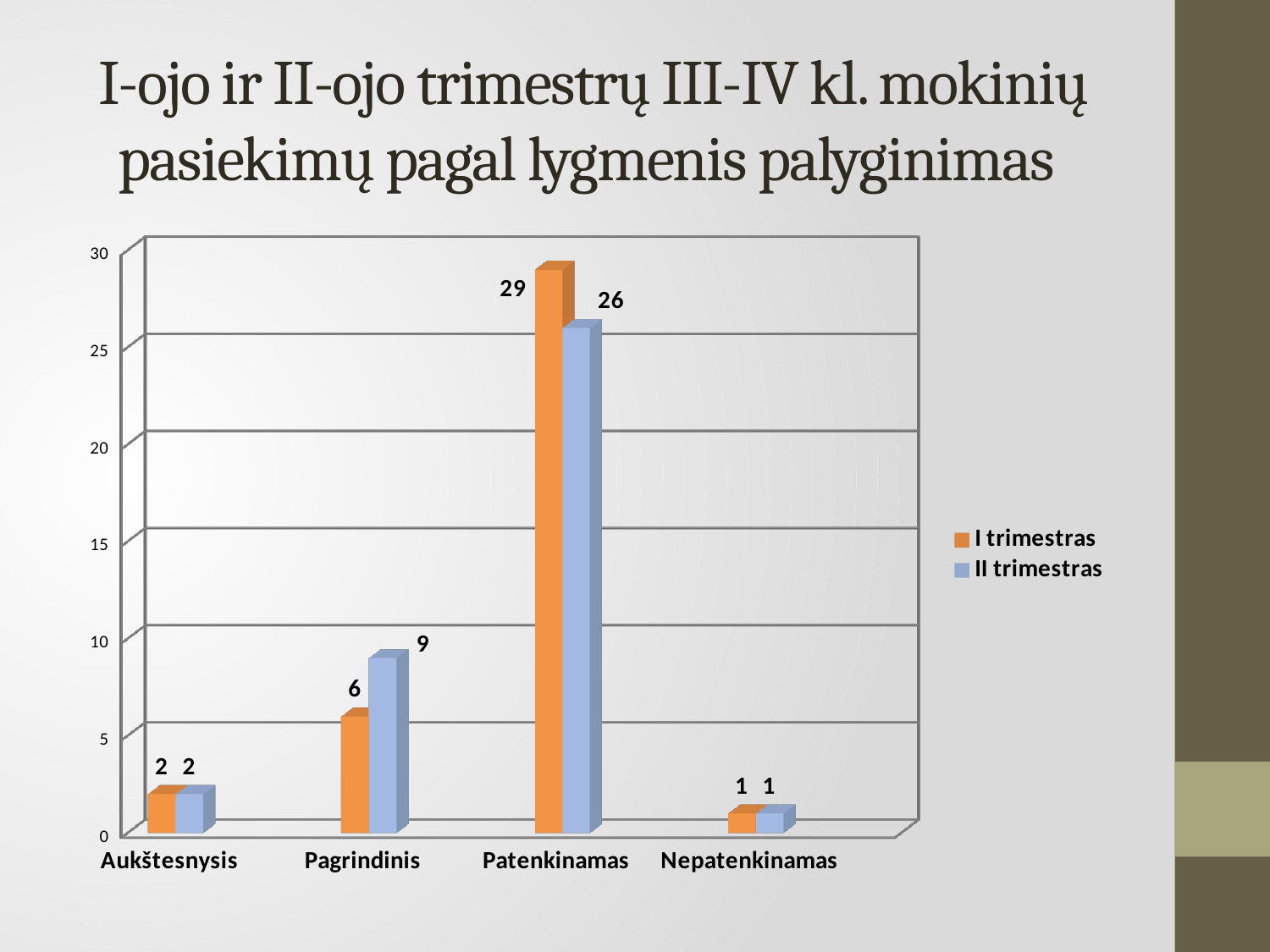
Is the value for Patenkinamas in the II trimestras series greater or less than 25? greater What is the value for Aukštesnysis in the I trimestras series? 2 Which category has the lowest value in the I trimestras series? Nepatenkinamas How many series does the legend list? 2 How many categories are shown on the x axis? 4 What is the difference between the I trimestras and II trimestras values for Patenkinamas? 3 What is the value for Pagrindinis in the II trimestras series? 9 What is the value for Patenkinamas in the I trimestras series? 29 Which category has the highest value in the II trimestras series? Patenkinamas For Pagrindinis, which series has the larger value, I trimestras or II trimestras? II trimestras What is the value for Nepatenkinamas in the II trimestras series? 1 What kind of chart is shown on the slide? Bar chart